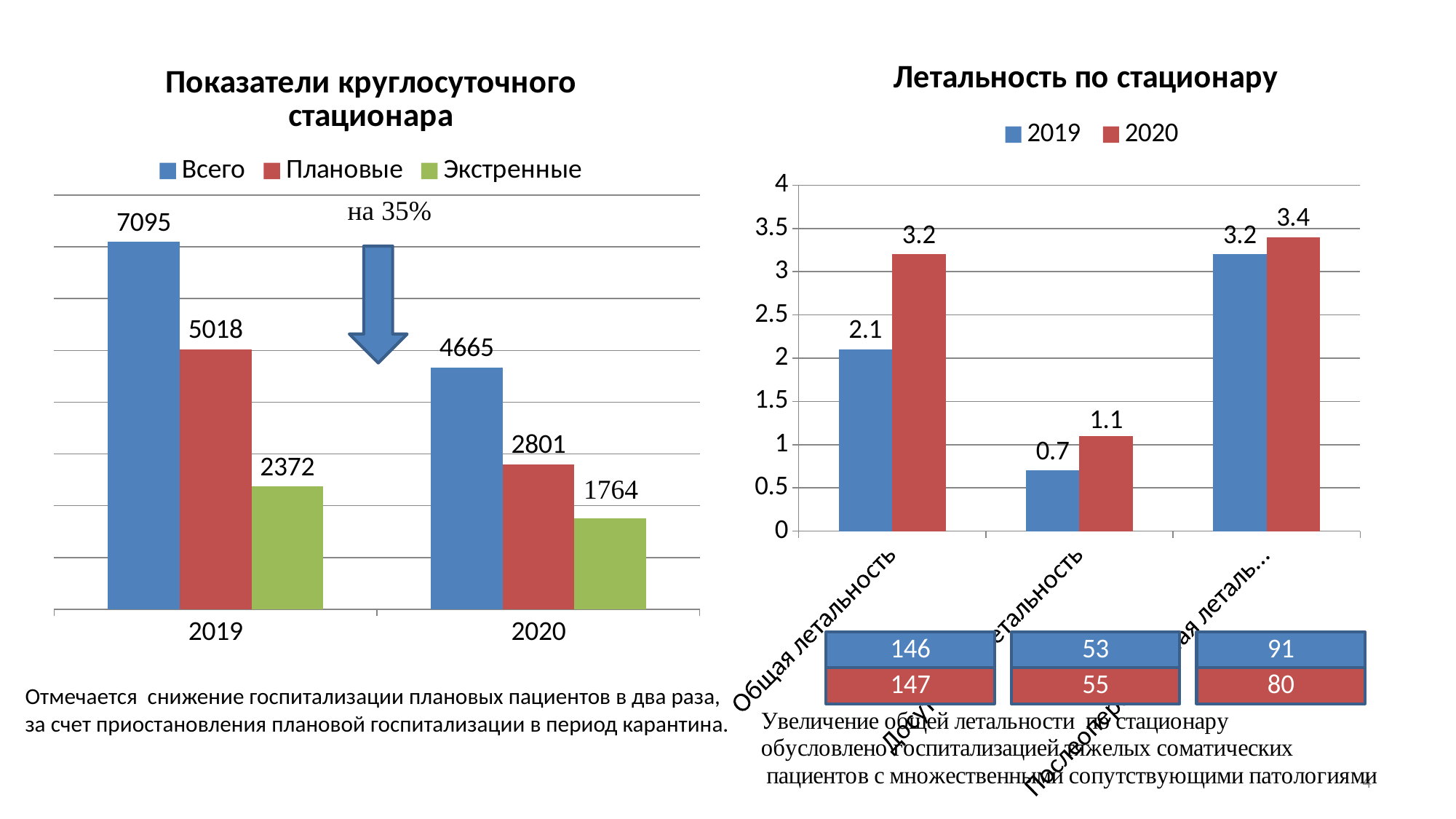
In the chart 'Показатели круглосуточного стационара', what is the value of Всего for 2019? 7095 In the chart 'Летальность по стационару', what is the difference between the 2020 and 2019 values for Общая летальность? 1.1 In the chart 'Летальность по стационару', what is the value for Общая летальность in 2020? 3.2 In the chart 'Показатели круглосуточного стационара', what is the value of Экстренные for 2019? 2372 In the chart 'Показатели круглосуточного стационара', how many series does the legend list? 3 In the chart 'Показатели круглосуточного стационара', does the value of Всего rise or fall from 2019 to 2020? fall In the chart 'Показатели круглосуточного стационара', which series has the lowest value in 2020? Экстренные In the chart 'Летальность по стационару', what is the value for Общая летальность in 2019? 2.1 In the chart 'Показатели круглосуточного стационара', what is the difference between Всего in 2019 and Всего in 2020? 2430 In the chart 'Показатели круглосуточного стационара', what is the value of Плановые for 2020? 2801 In the chart 'Летальность по стационару', which is larger for the middle category: the 2019 value or the 2020 value? 2020 What type of chart is 'Летальность по стационару'? bar chart